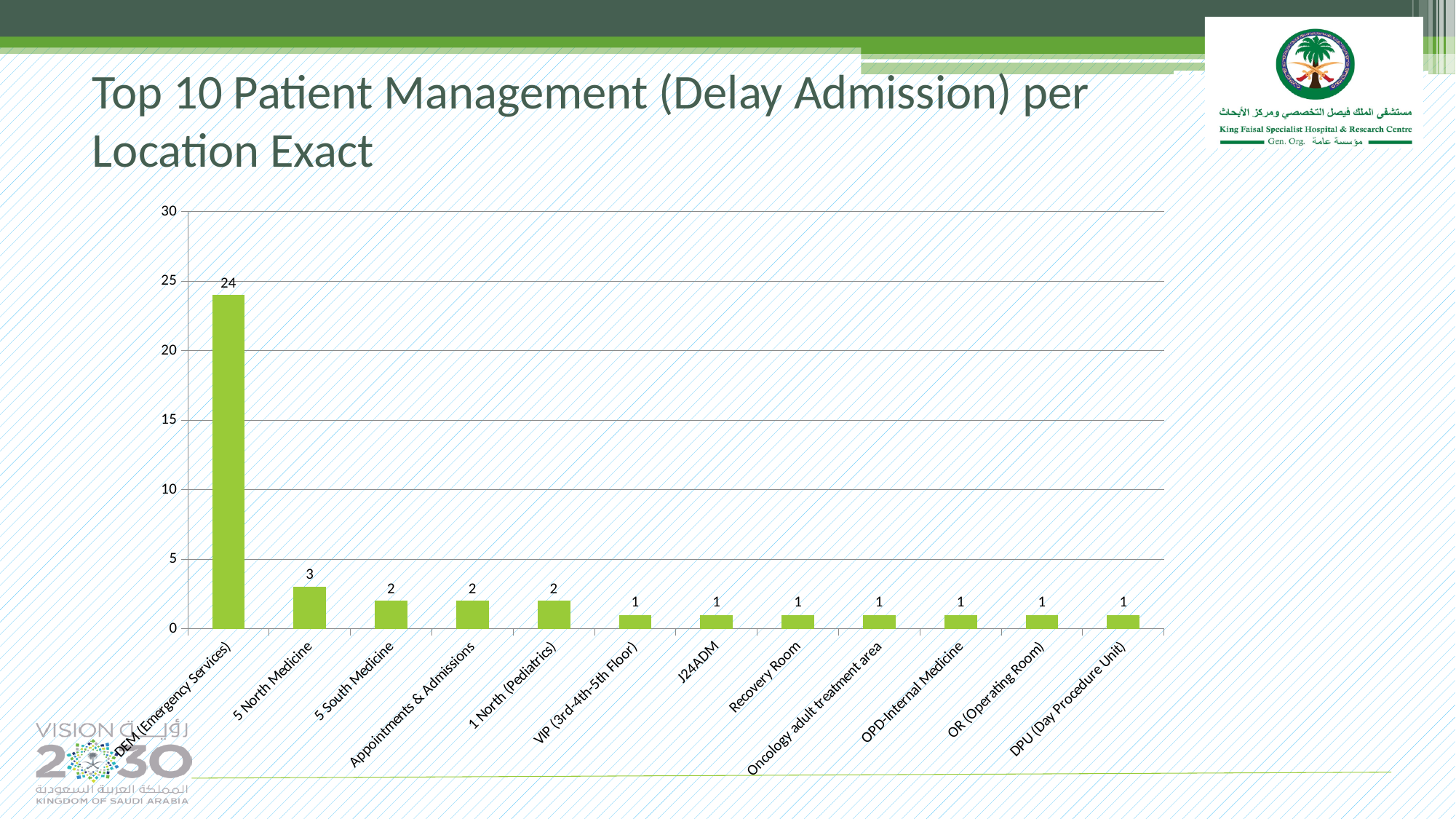
What is the value for Recovery Room? 1 What kind of chart is shown on the slide? Bar chart What is the value for 5 North Medicine? 3 Is the value for DEM (Emergency Services) greater or less than 20? greater How many locations are shown on the chart? 12 What is the difference between the values for DEM (Emergency Services) and 5 North Medicine? 21 What is the value for DEM (Emergency Services)? 24 Which location has the highest value? DEM (Emergency Services) What is the title of the slide? Top 10 Patient Management (Delay Admission) per Location Exact Which is larger, the value for Appointments & Admissions or the value for J24ADM? Appointments & Admissions What is the value for 1 North (Pediatrics)? 2 What is the difference between the values for 5 North Medicine and 5 South Medicine? 1